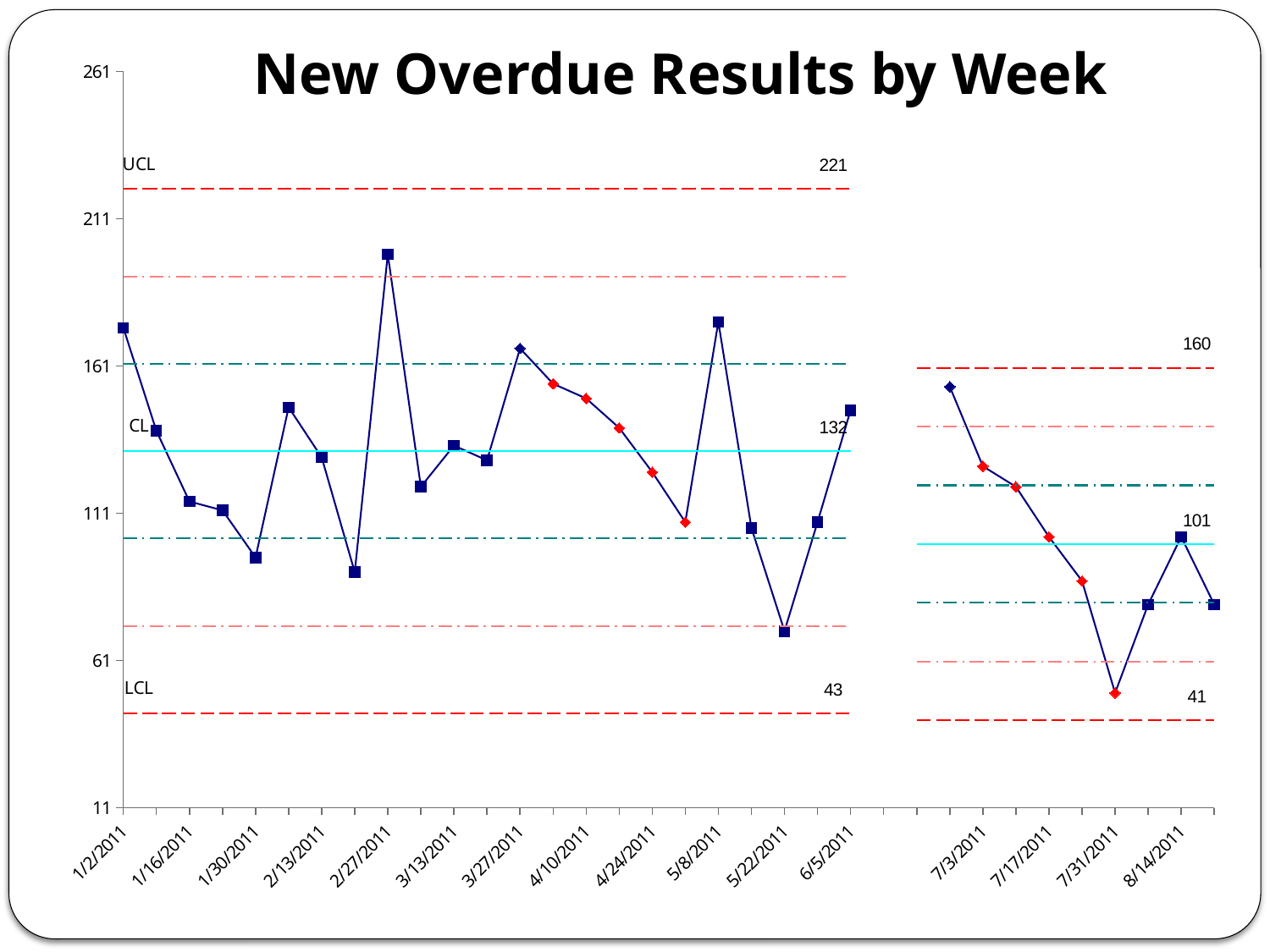
Is the value for 2/27/2011 greater or less than 161? greater What is the title of the chart? New Overdue Results by Week What is the upper control limit value printed for the second (right) segment of the chart? 160 What is the difference between the UCL (221) and the LCL (43) in the first segment? 178 What is the lower control limit value printed for the second (right) segment of the chart? 41 What is the center line value printed for the second (right) segment of the chart? 101 What is the CL value printed for the first (left) segment of the chart? 132 What is the LCL value printed for the first (left) segment of the chart? 43 By how much does the center line drop from the first segment (132) to the second segment (101)? 31 What kind of chart is shown on the slide? line chart What is the UCL value printed for the first (left) segment of the chart? 221 Which date has the highest plotted value in the first (left) segment of the chart? 2/27/2011